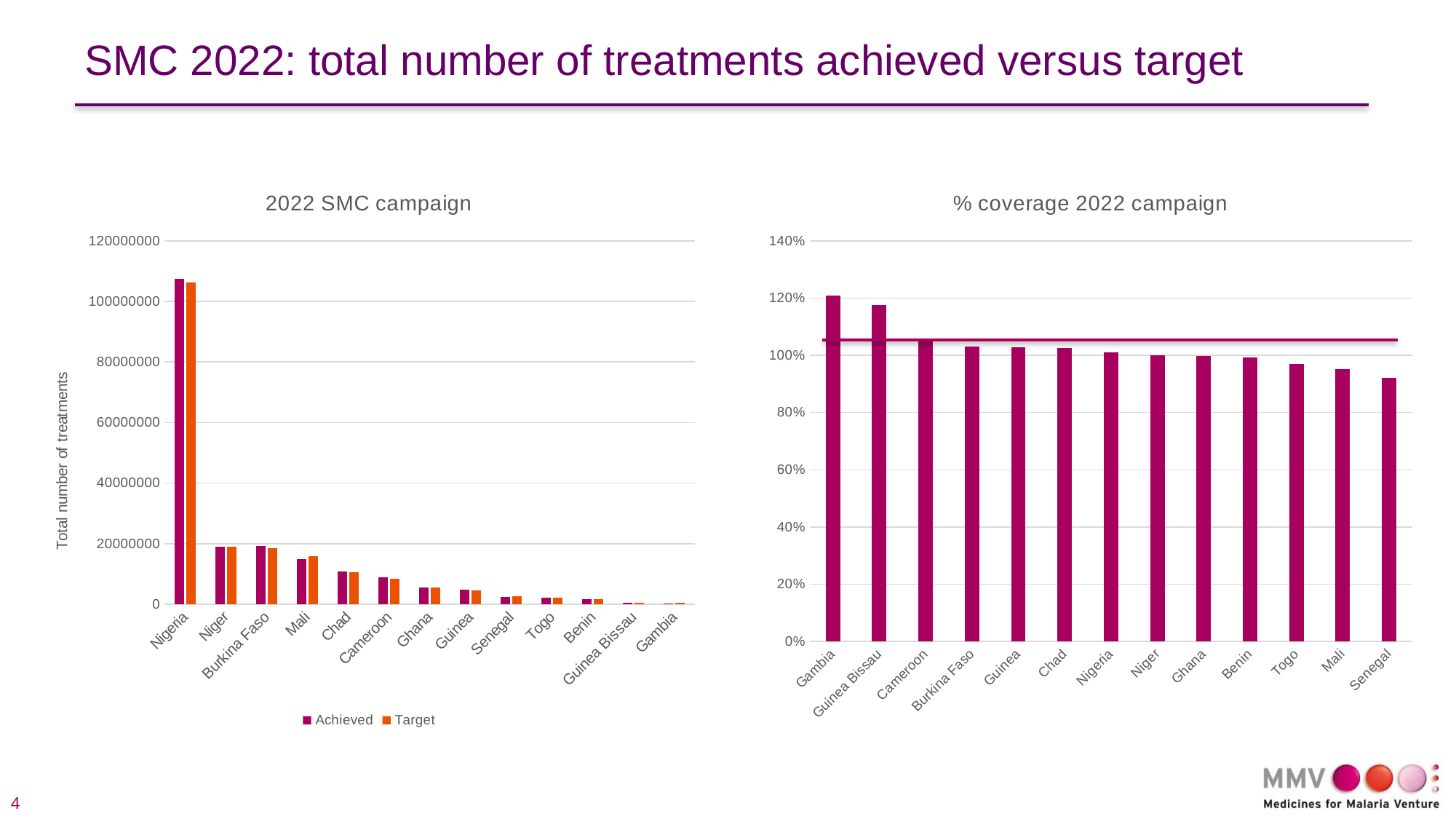
In the '% coverage 2022 campaign' chart, do the values rise or fall from left to right along the x axis? fall In the '% coverage 2022 campaign' chart, is the value for Senegal greater or less than 100%? less In the '2022 SMC campaign' chart, which country has the lowest number of treatments achieved? Gambia In the '2022 SMC campaign' chart, is the Achieved value for Mali greater or less than 20000000? less In the '2022 SMC campaign' chart, which country has the highest number of treatments achieved? Nigeria What is the y-axis title of the '2022 SMC campaign' chart? Total number of treatments What kind of chart is the '2022 SMC campaign' chart on the left? bar chart In the '2022 SMC campaign' chart, is the Target value for Nigeria greater or less than 100000000? greater How many series does the legend of the '2022 SMC campaign' chart list? 2 In the '% coverage 2022 campaign' chart, which country has the highest coverage? Gambia How many countries are shown on the x axis of the '2022 SMC campaign' chart? 13 In the '% coverage 2022 campaign' chart, which country has the lowest coverage? Senegal